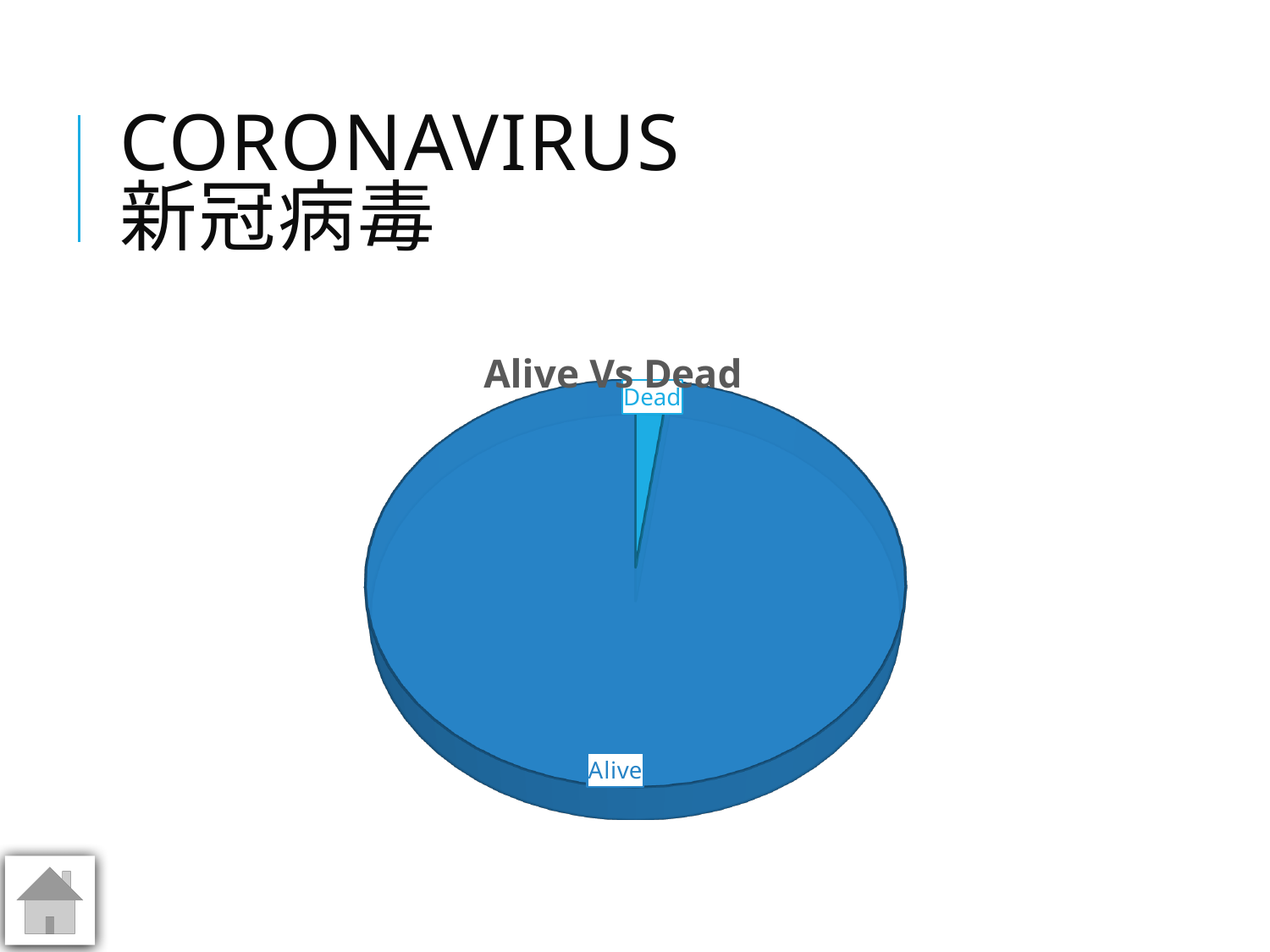
What kind of chart is shown on the slide? pie chart What are the labels of the two slices in the pie chart? Alive and Dead How many slices does the pie chart have? 2 Which slice of the pie chart is the largest? Alive Which is larger in the pie chart, Alive or Dead? Alive What is the title of the chart? Alive Vs Dead Which slice of the pie chart is the smallest? Dead